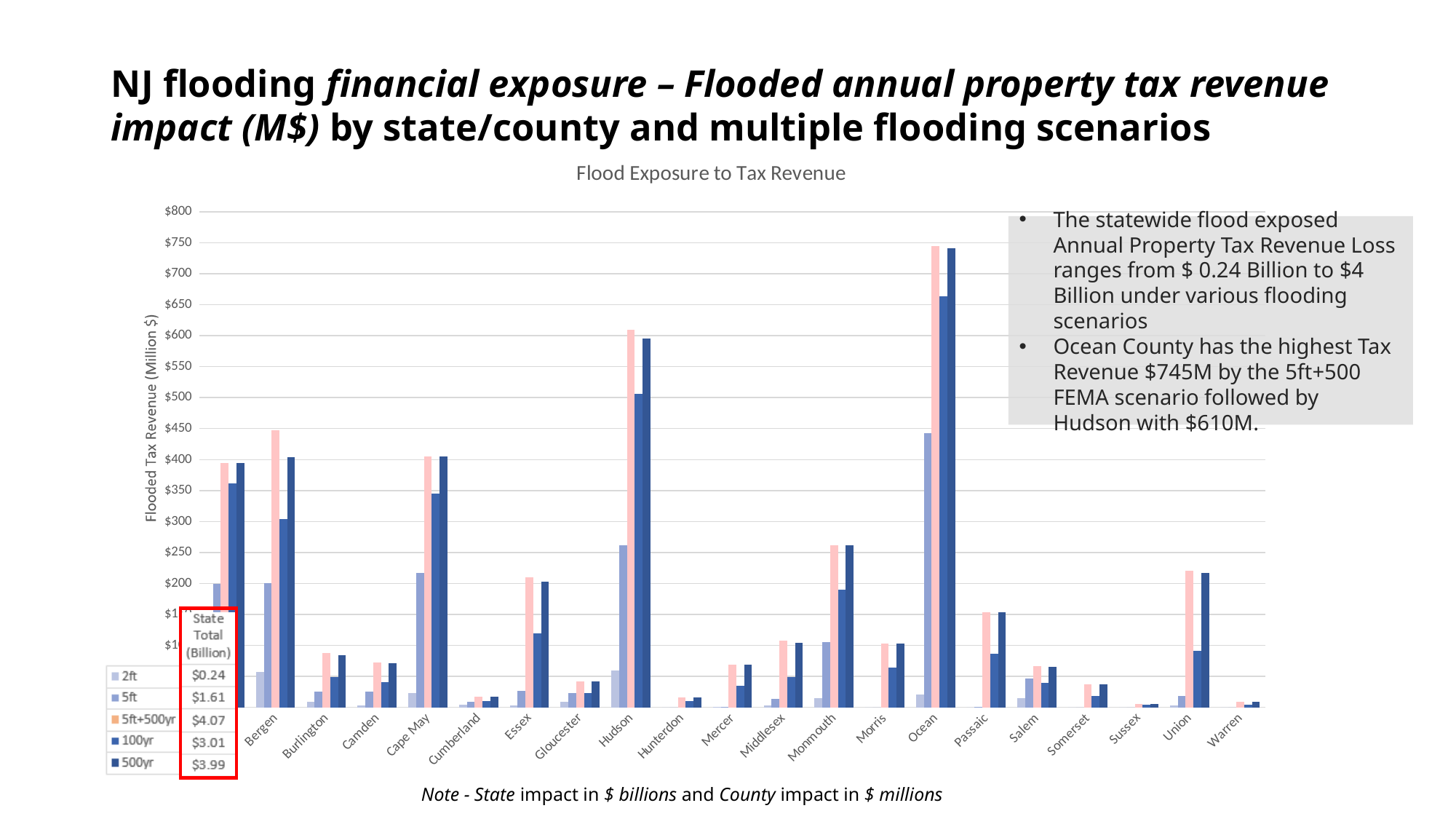
What is the difference between the State Total for the 5ft+500yr scenario and the 2ft scenario, in billions? $3.83 What kind of chart is shown on the slide? Bar chart Is the 5ft+500yr value for Ocean greater or less than $700? greater What is the title of the chart? Flood Exposure to Tax Revenue What is the State Total (Billion) for the 2ft scenario shown in the legend table? $0.24 What is the State Total (Billion) for the 5ft+500yr scenario shown in the legend table? $4.07 Is the 2ft value for Ocean greater or less than $500? less Which county has the highest 5ft+500yr bar? Ocean Which is larger, the 100yr value for Ocean or the 100yr value for Hudson? Ocean How many series does the chart legend list? 5 What is the label of the vertical axis? Flooded Tax Revenue (Million $) What is the State Total (Billion) for the 500yr scenario shown in the legend table? $3.99